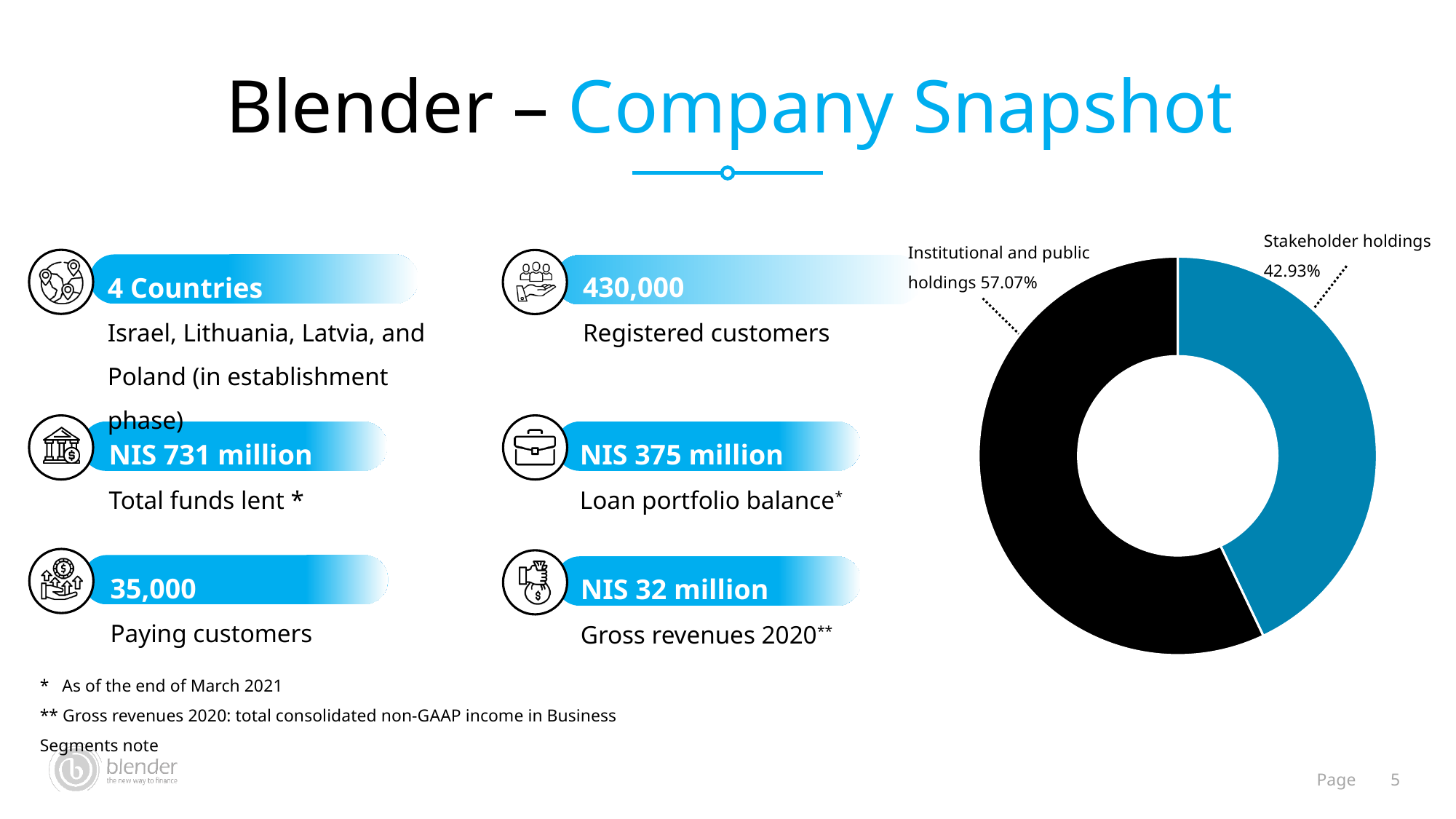
What colour is the Institutional and public holdings slice? Black How many slices does the doughnut chart have? 2 What is the total of the two slices shown in the doughnut chart? 100% What kind of chart is shown on the slide? Doughnut chart What share of holdings is labelled as Stakeholder holdings? 42.93% Which is larger: Institutional and public holdings or Stakeholder holdings? Institutional and public holdings Which slice of the doughnut chart is the largest? Institutional and public holdings What colour is the Stakeholder holdings slice? Blue Which slice of the doughnut chart is the smallest? Stakeholder holdings What is the difference in percentage points between Institutional and public holdings and Stakeholder holdings? 14.14 What share of holdings is labelled as Institutional and public holdings? 57.07%